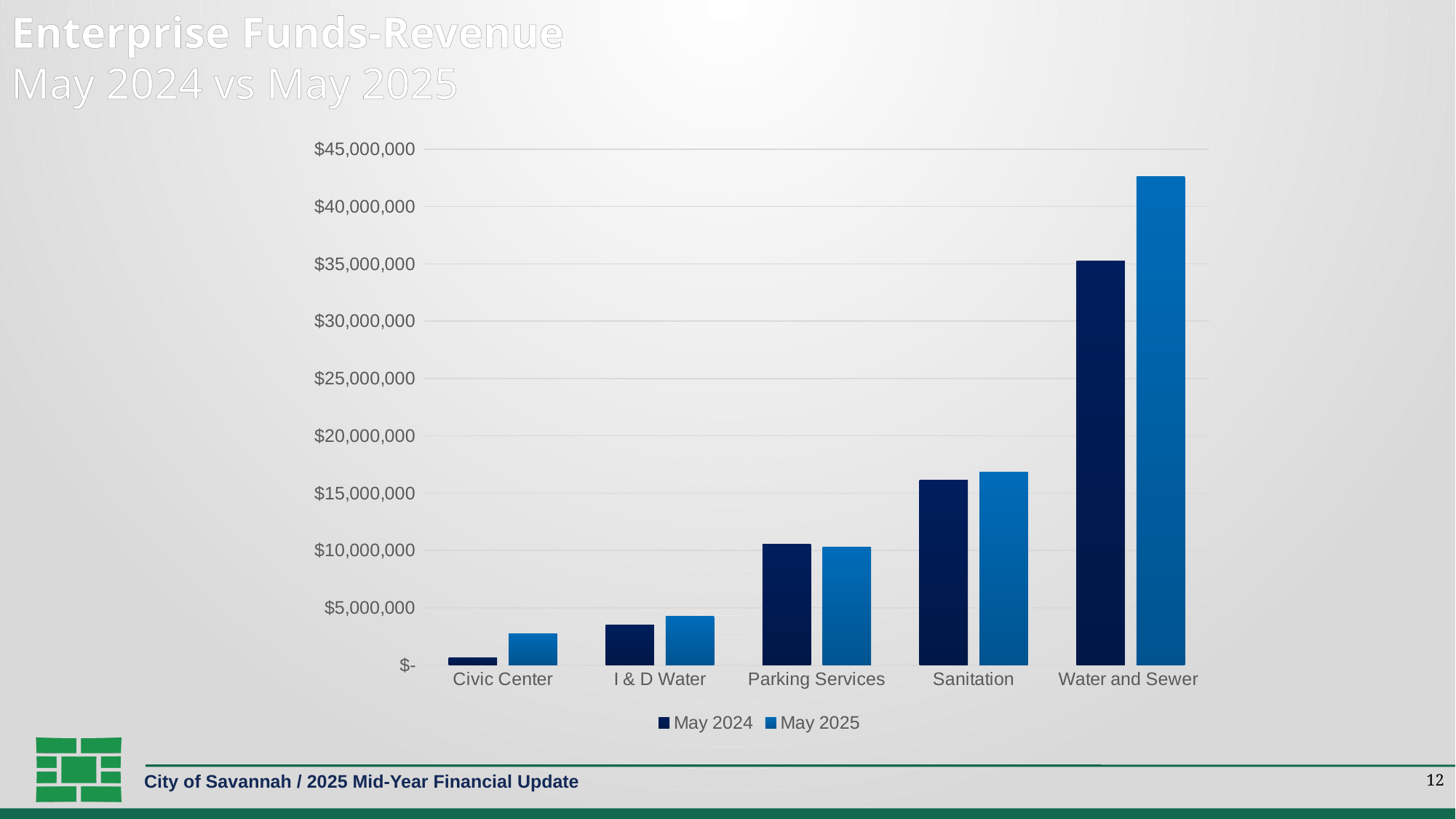
Is the May 2024 value for Sanitation greater or less than $15,000,000? greater How many series does the chart's legend list? 2 How many categories are shown on the x axis of the chart? 5 What kind of chart is shown on the slide? bar chart Which category has the highest May 2025 revenue? Water and Sewer Is the May 2025 value for Civic Center greater or less than $5,000,000? less Is the May 2025 value for Water and Sewer greater or less than $40,000,000? greater What are the two series named in the chart's legend? May 2024 and May 2025 For Civic Center, which series has the larger value, May 2024 or May 2025? May 2025 Which category has the lowest May 2024 revenue? Civic Center For Water and Sewer, which series has the larger value, May 2024 or May 2025? May 2025